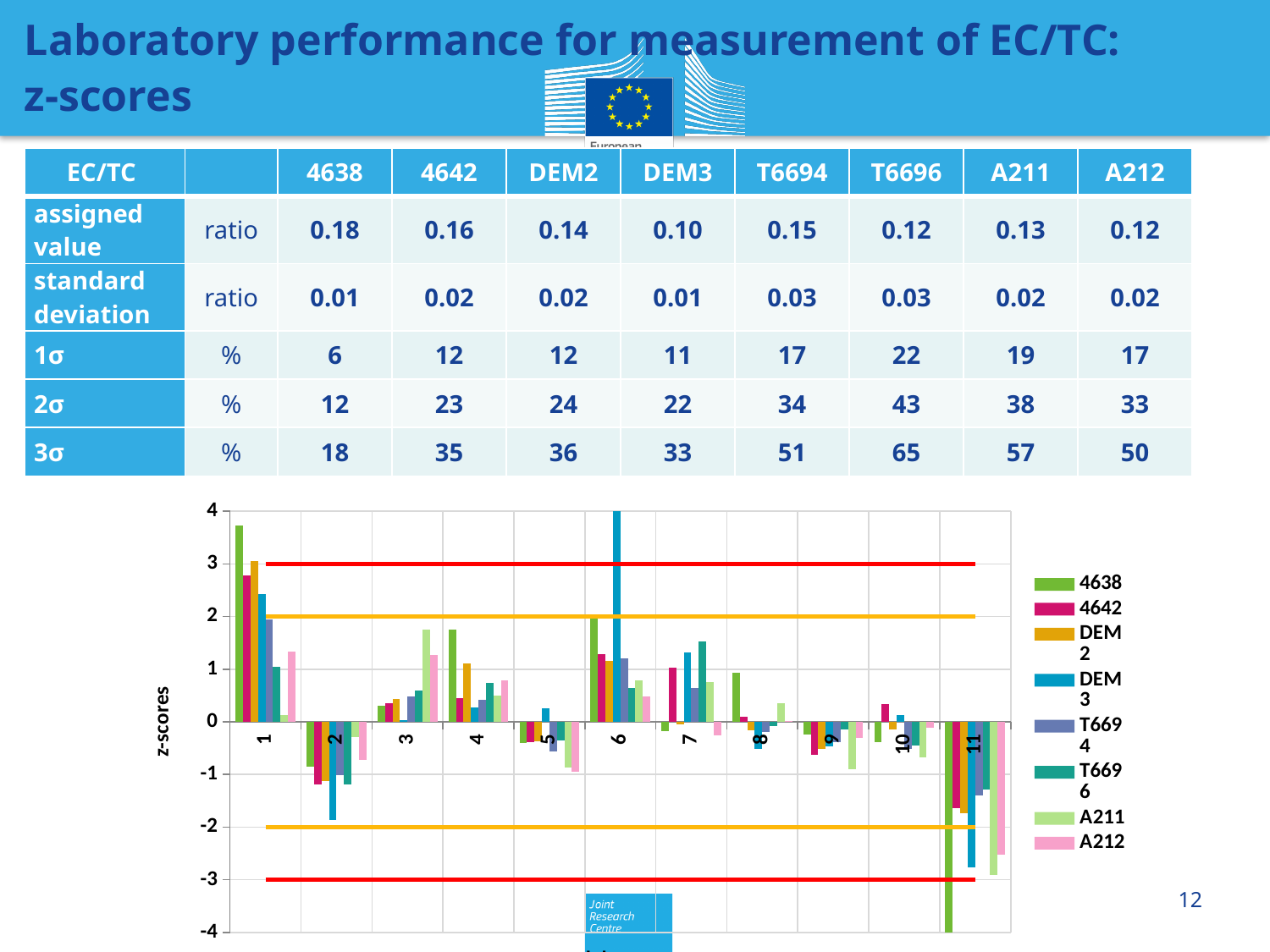
In the z-scores chart, is the value for laboratory 2 in series DEM3 greater or less than -1? less In the z-scores chart, is the value for laboratory 11 in series DEM3 greater or less than -2? less What is the highest value shown on the vertical axis of the z-scores chart? 4 How many series does the legend of the z-scores chart list? 8 In the z-scores chart, is the value for laboratory 4 in series 4638 greater or less than 1? greater What kind of chart is shown at the bottom of the slide? bar chart How many laboratory categories are shown along the x axis of the z-scores chart? 11 What is the label on the vertical axis of the chart? z-scores